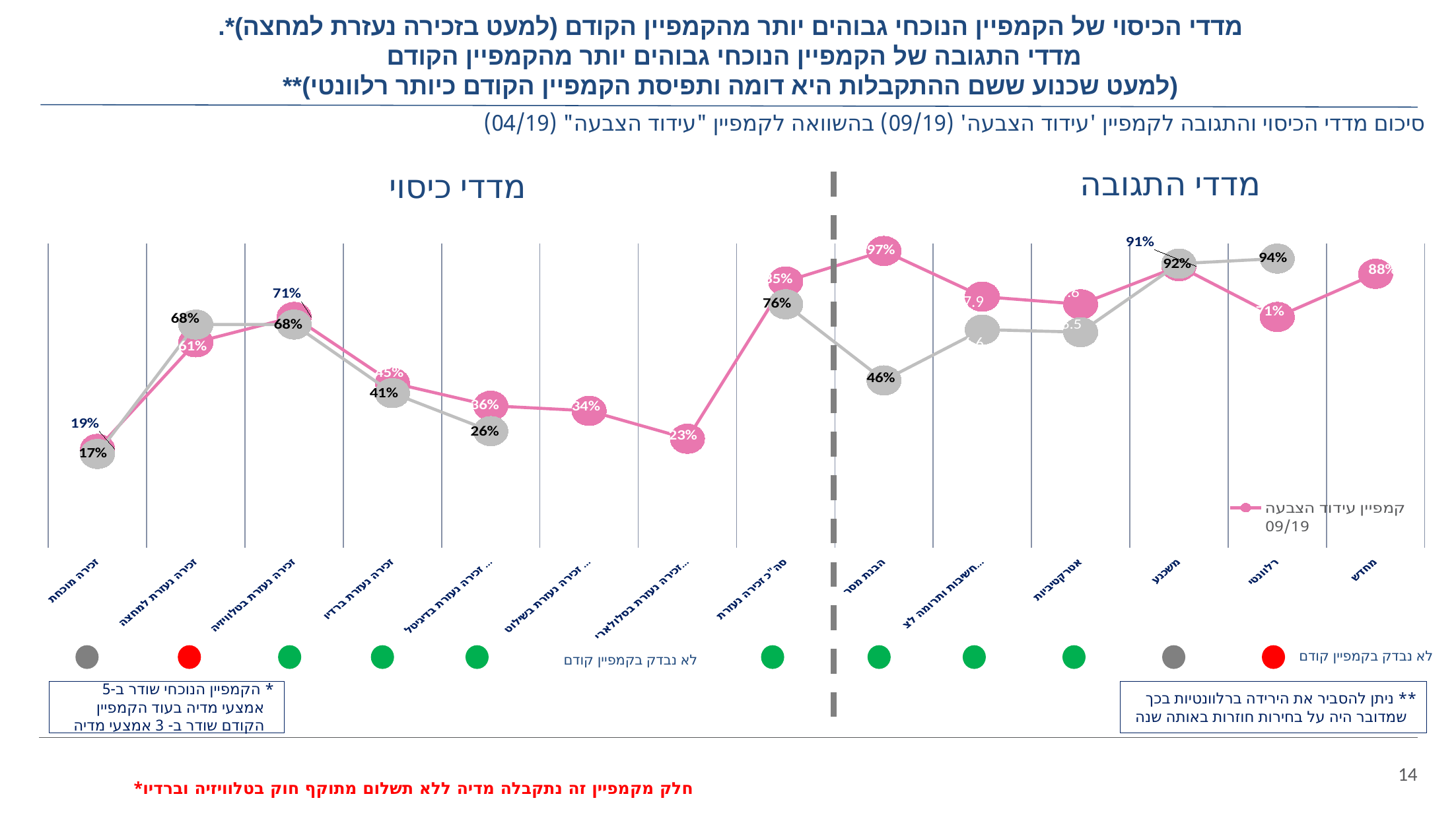
What is the value of the pink series (קמפיין עידוד הצבעה 09/19) for הבנת מסר? 97% What is the difference between the pink series and the grey series for הבנת מסר? 51 percentage points Which category has the highest value for the pink series (קמפיין עידוד הצבעה 09/19)? הבנת מסר What is the value of the pink series (קמפיין עידוד הצבעה 09/19) for מחדש? 88% Which category has the lowest value for the pink series (קמפיין עידוד הצבעה 09/19)? זכירה מוכחת What is the value of the grey series for זכירה מוכחת? 17% What is the value of the grey series for רלוונטי? 94% What is the value of the pink series (קמפיין עידוד הצבעה 09/19) for זכירה מוכחת? 19% What is the value of the grey series for זכירה נעזרת בדיגיטל? 26% For זכירה מוכחת, which series has the larger value, the pink series or the grey series? the pink series What is the value of the grey series for הבנת מסר? 46% What type of chart is shown on the slide? line chart